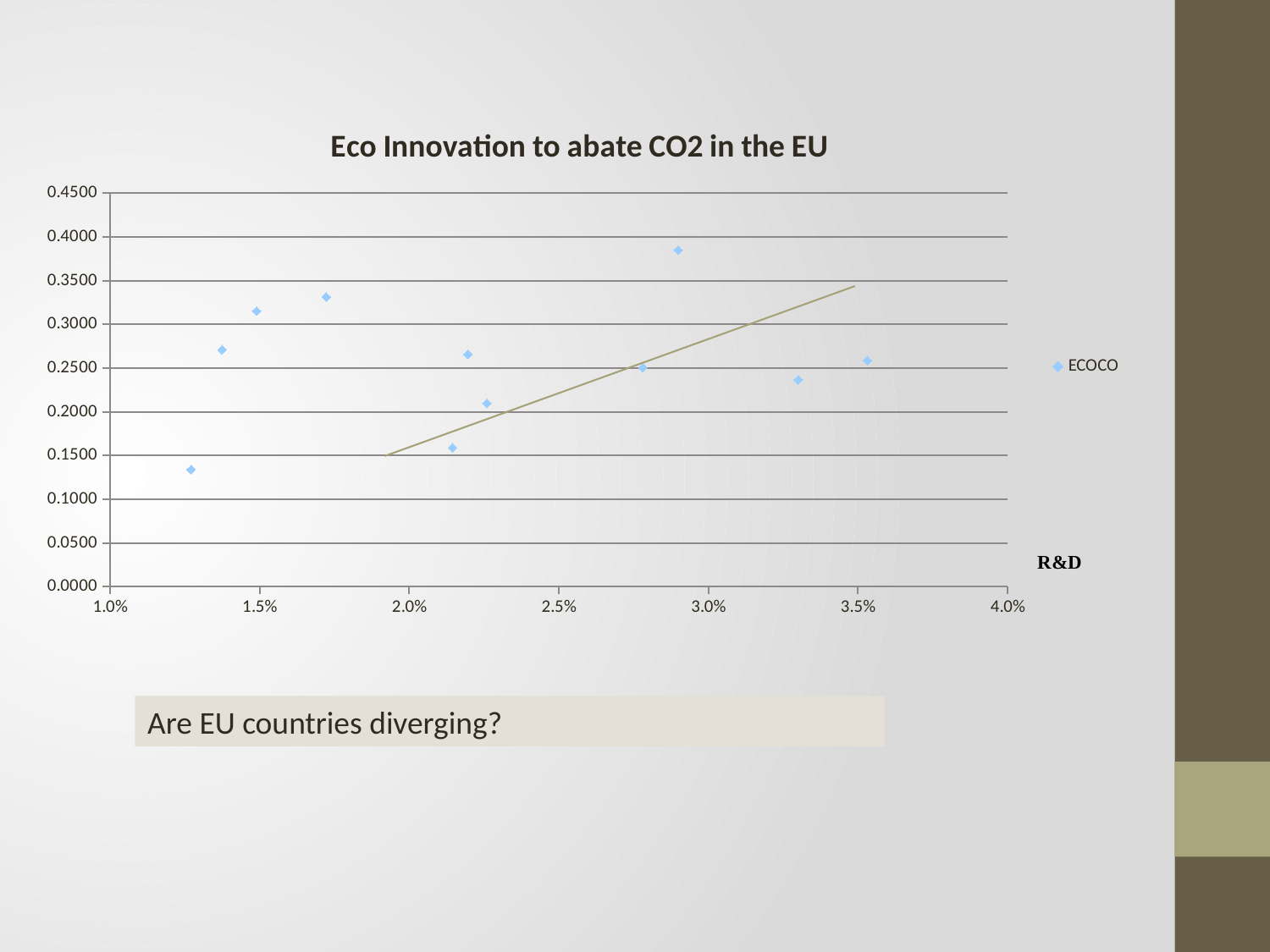
What kind of chart is shown on the slide? scatter chart Is the ECOCO value for the point at about 1.7% R&D greater or less than 0.3000? greater How many series does the legend list? 1 What is the highest value shown on the vertical axis? 0.4500 Is the highest ECOCO point on the chart greater or less than 0.3500? greater Which is larger: the ECOCO value of the point near 2.9% R&D or the point near 2.8% R&D? the point near 2.9% R&D What is the name of the series shown in the legend? ECOCO Is the ECOCO value for the point at about 3.3% R&D greater or less than 0.2500? less Does the trend line drawn on the chart rise or fall as R&D increases? rise What is the title of the chart? Eco Innovation to abate CO2 in the EU